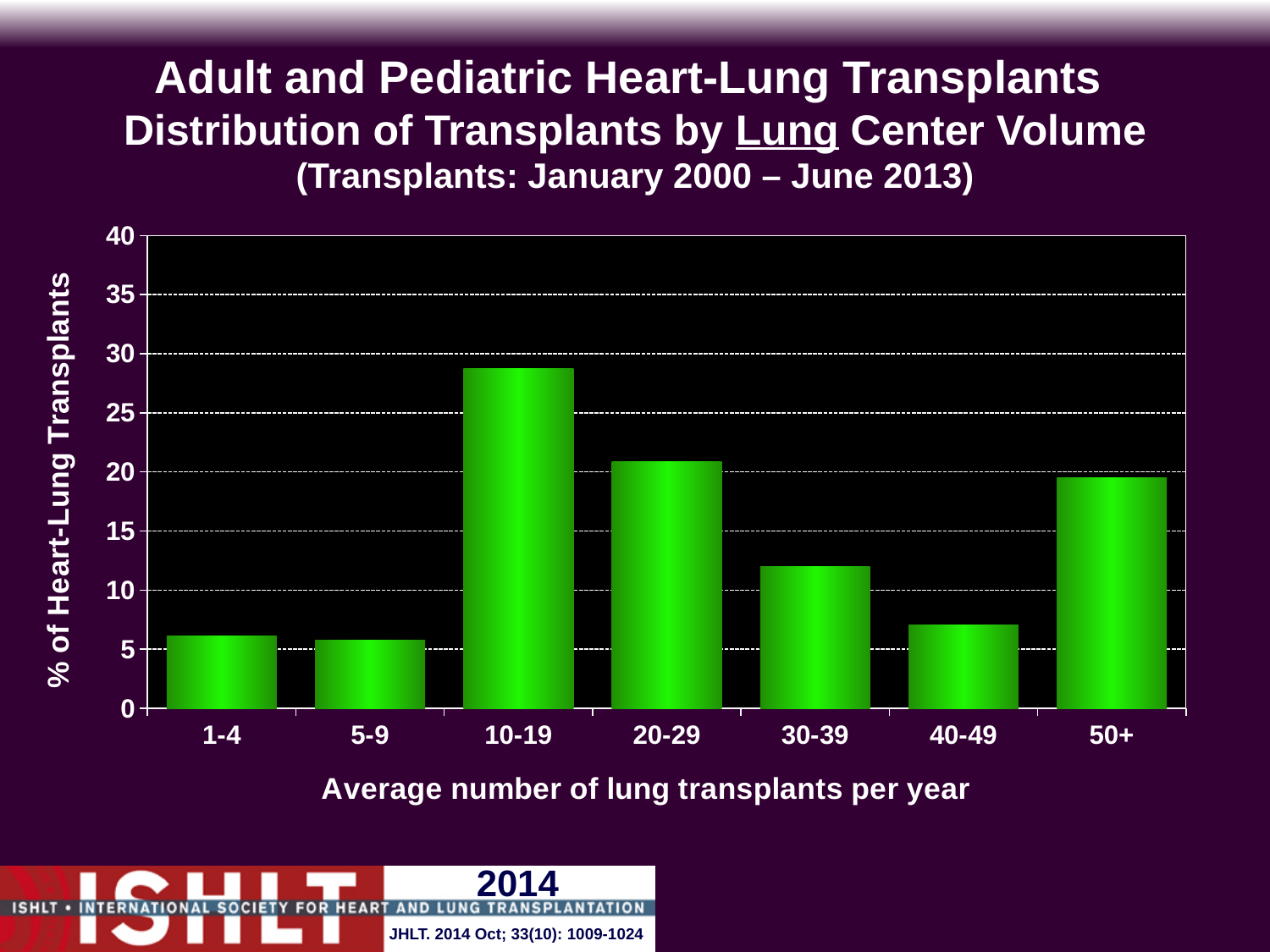
How many center-volume categories are shown on the x axis? 7 Is the value for the 10-19 category greater or less than 30? less Which has a larger percentage of heart-lung transplants, the 20-29 category or the 30-39 category? 20-29 Is the value for the 40-49 category greater or less than 10? less Which has a larger percentage of heart-lung transplants, the 50+ category or the 40-49 category? 50+ What kind of chart is shown on the slide? bar chart What is the label of the x axis? Average number of lung transplants per year Which center-volume category has the highest percentage of heart-lung transplants? 10-19 Is the value for the 10-19 category greater or less than 25? greater